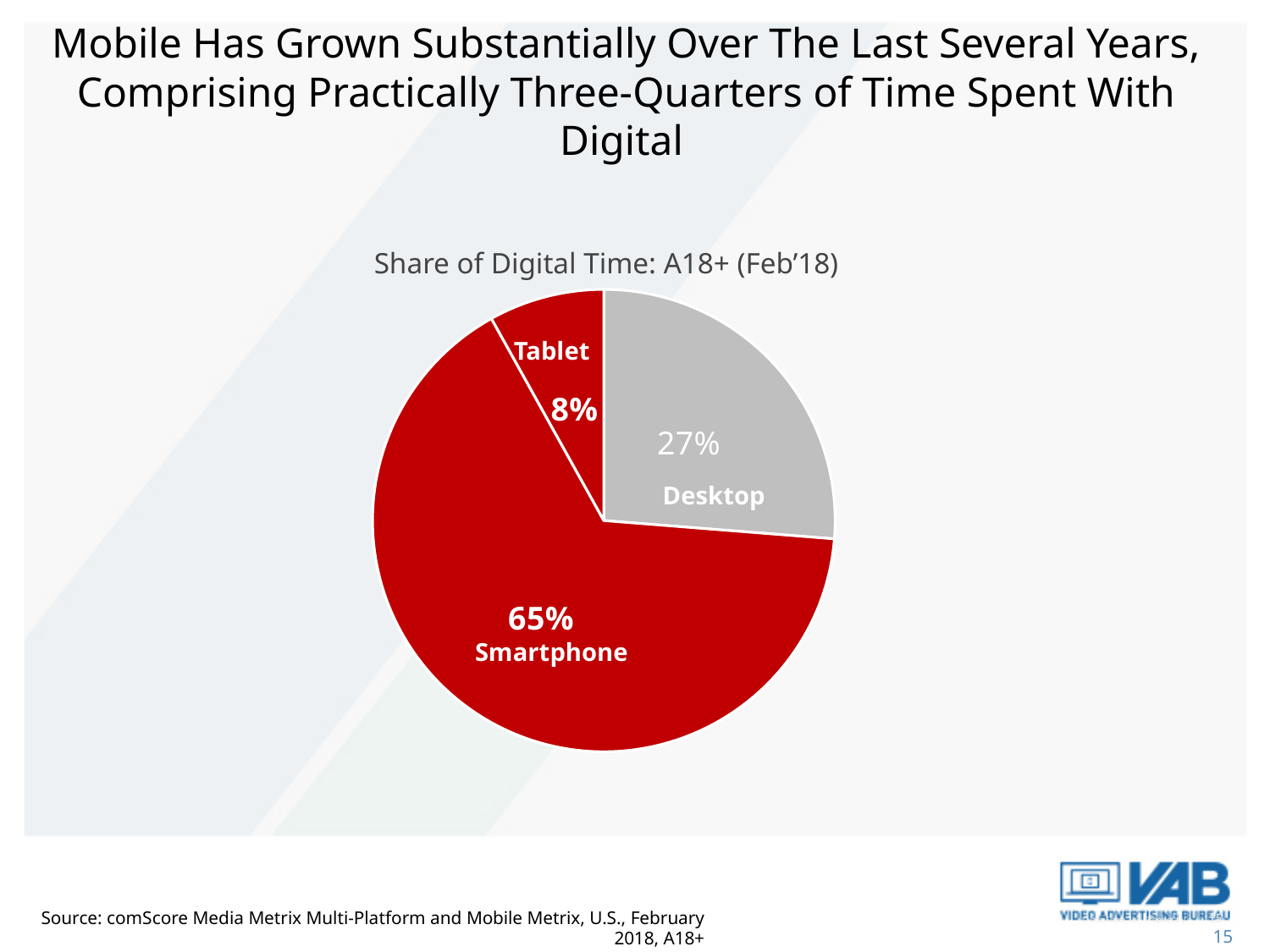
What is the difference in percentage points between the Desktop and Tablet shares? 19 What is the difference in percentage points between the Smartphone and Desktop shares? 38 What share of digital time does Desktop account for? 27% What share of digital time does Smartphone account for? 65% Which has a larger share of digital time, Desktop or Tablet? Desktop What share of digital time does Tablet account for? 8% How many slices does the pie chart have? 3 What colour is the Desktop slice of the pie chart? Grey Which category has the largest share of digital time? Smartphone What kind of chart is shown on the slide? Pie chart What is the title of the chart? Share of Digital Time: A18+ (Feb'18) Which category has the smallest share of digital time? Tablet